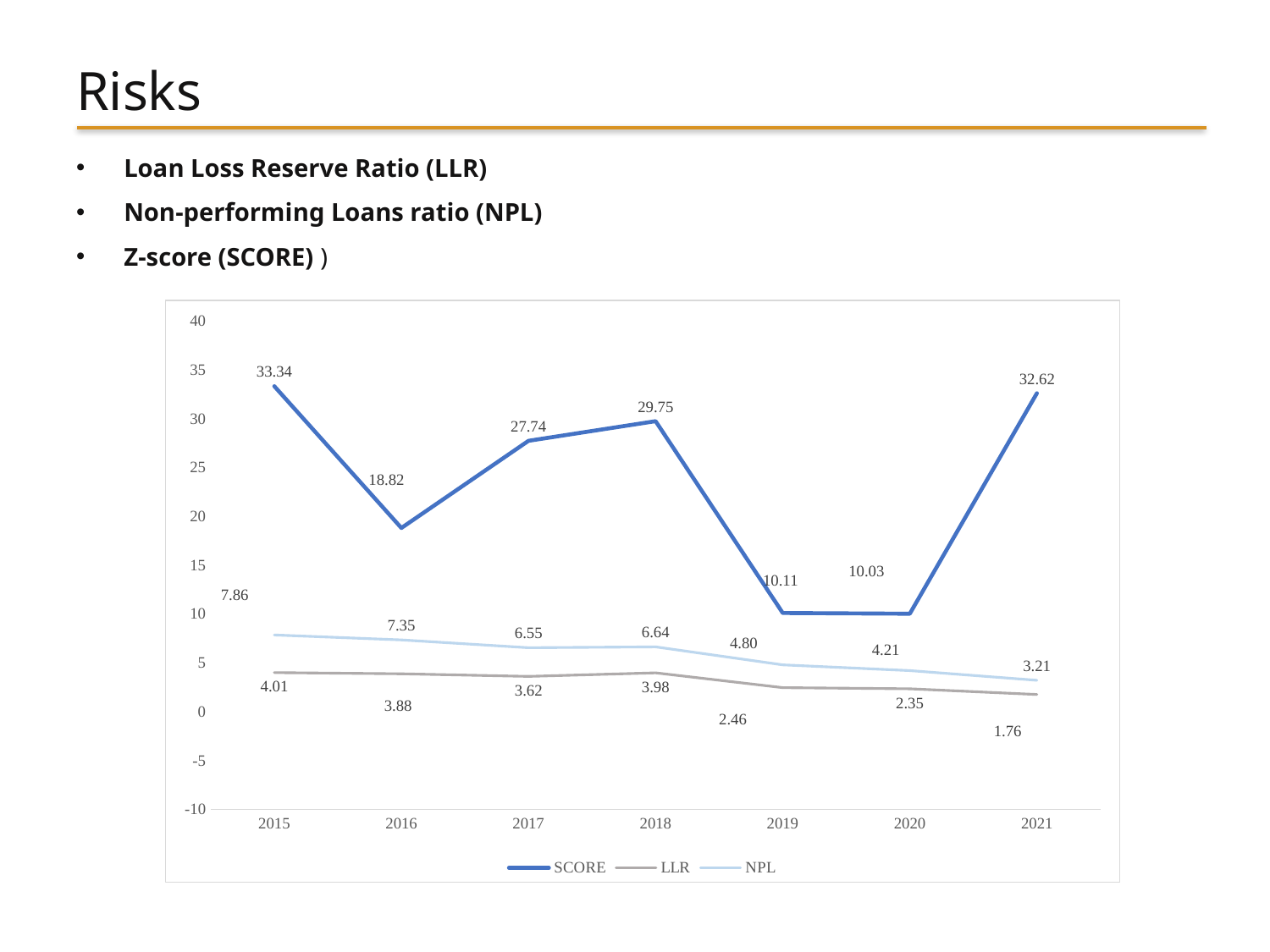
In which year is the SCORE value highest? 2015 In which year is the NPL value lowest? 2021 Does the NPL series generally rise or fall from 2015 to 2021? fall What is the SCORE value for 2018? 29.75 How many years are shown on the x axis? 7 What is the NPL value for 2019? 4.80 Which series is drawn with the thick dark blue line? SCORE How many series does the legend list? 3 What type of chart is shown on the slide? line chart What is the difference between the SCORE values for 2015 and 2016? 14.52 Which is larger, the LLR value for 2018 or the LLR value for 2017? 2018 What is the LLR value for 2021? 1.76